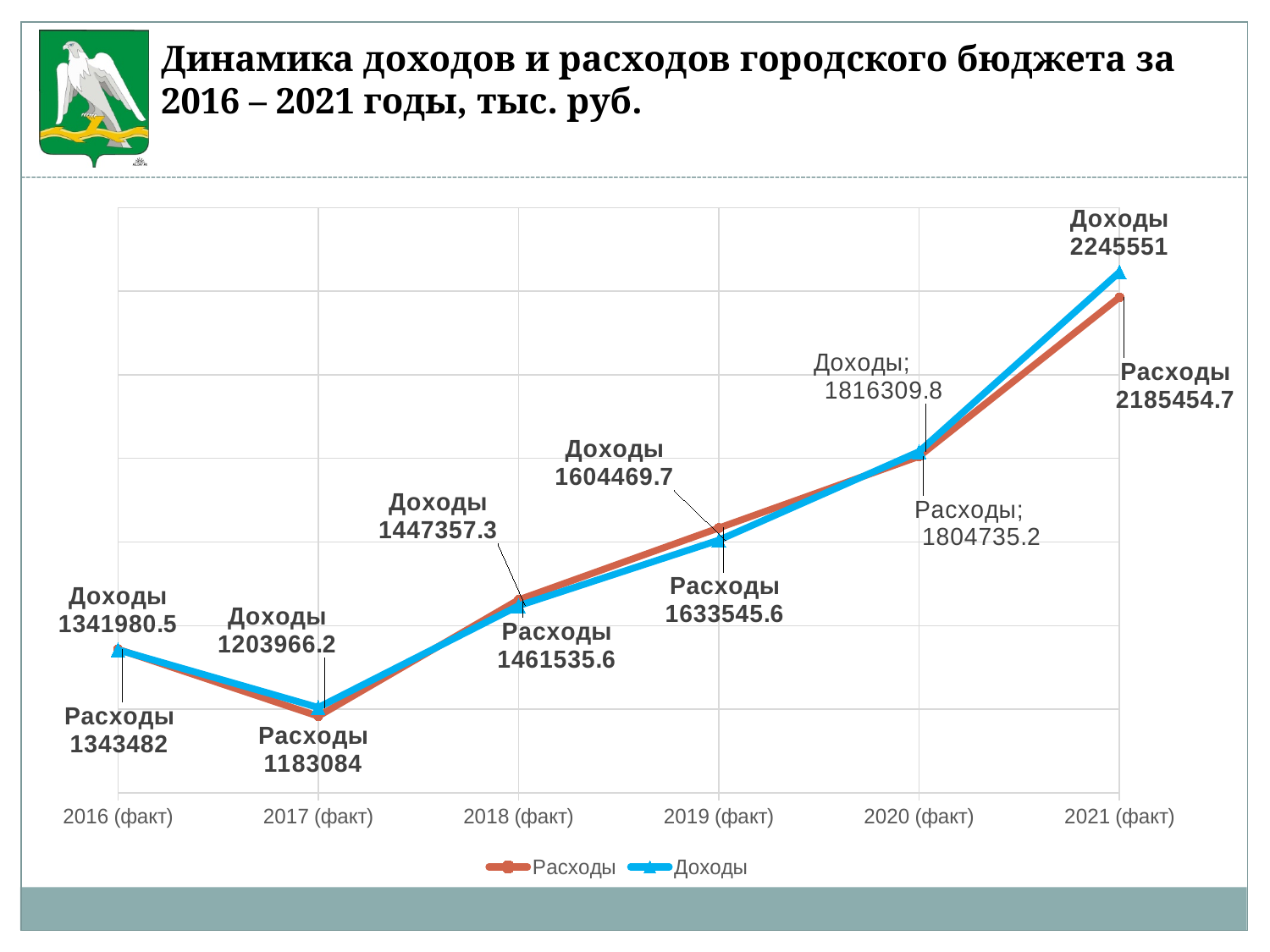
Do the Доходы values rise or fall from 2017 (факт) to 2021 (факт)? Rise In which year is Расходы the lowest? 2017 (факт) What is the value of Расходы for 2017 (факт)? 1183084 How many series does the legend list? 2 How many years are shown on the x axis? 6 What is the value of Доходы for 2021 (факт)? 2245551 What is the value of Доходы for 2019 (факт)? 1604469.7 What kind of chart is shown on the slide? Line chart In which year is Доходы the highest? 2021 (факт) What is the difference between Доходы and Расходы in 2021 (факт)? 60096.3 Which is larger in 2019 (факт), Доходы or Расходы? Расходы What is the value of Расходы for 2020 (факт)? 1804735.2